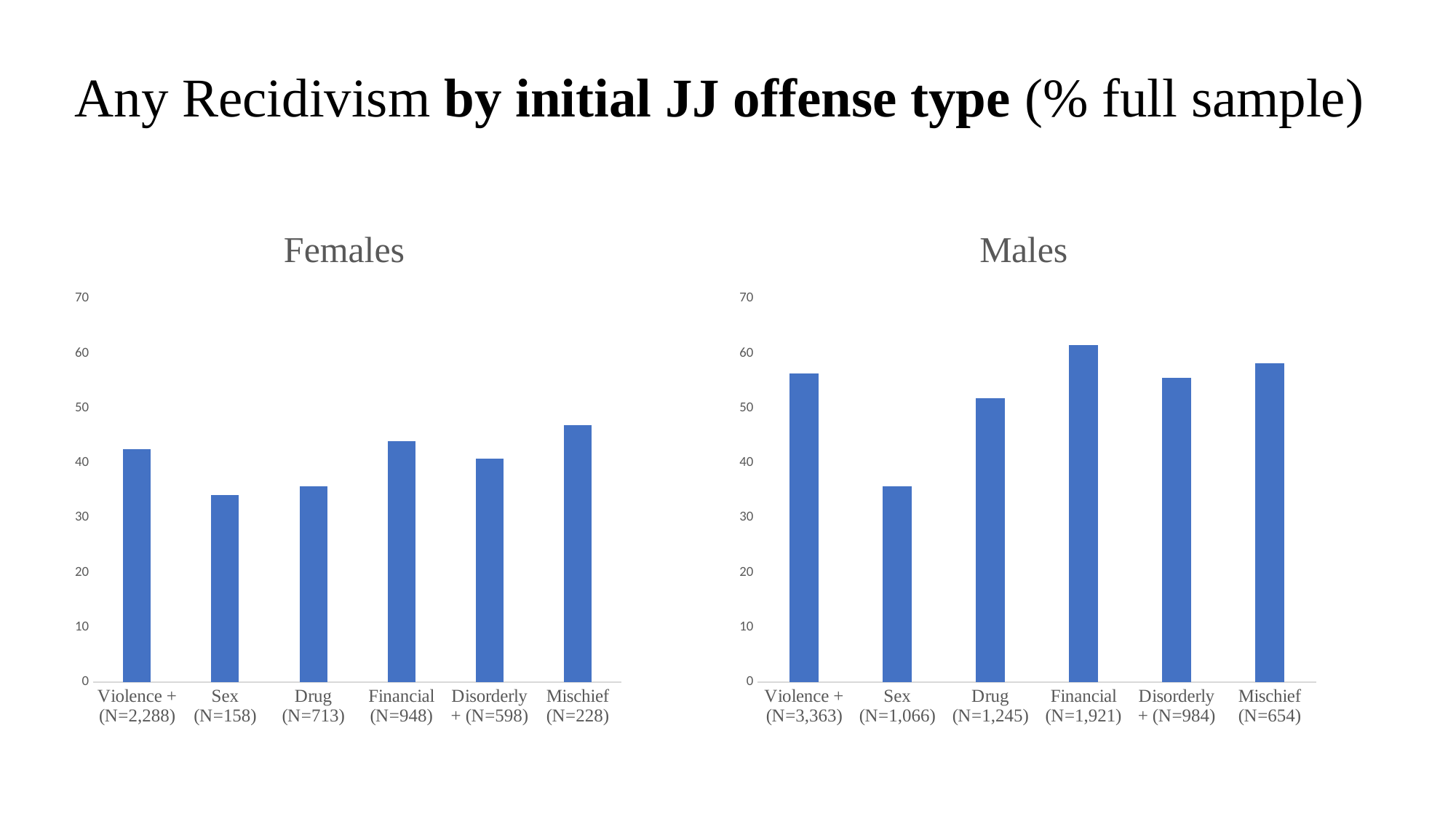
In the Males chart, is the value for Financial greater or less than 60? greater In the Females chart, is the value for Violence + greater or less than 40? greater In the Females chart, which offense type has the lowest recidivism percentage? Sex (N=158) In the Males chart, which offense type has the lowest recidivism percentage? Sex (N=1,066) In the Females chart, which is larger, the value for Financial or the value for Drug? Financial In the Females chart, is the value for Sex greater or less than 40? less What kind of chart is the Females chart? bar chart What is the title of the chart on the right side of the slide? Males How many offense-type categories are shown in the Males chart? 6 In the Males chart, which offense type has the highest recidivism percentage? Financial (N=1,921) In the Males chart, which is larger, the value for Drug or the value for Sex? Drug In the Females chart, which offense type has the highest recidivism percentage? Mischief (N=228)